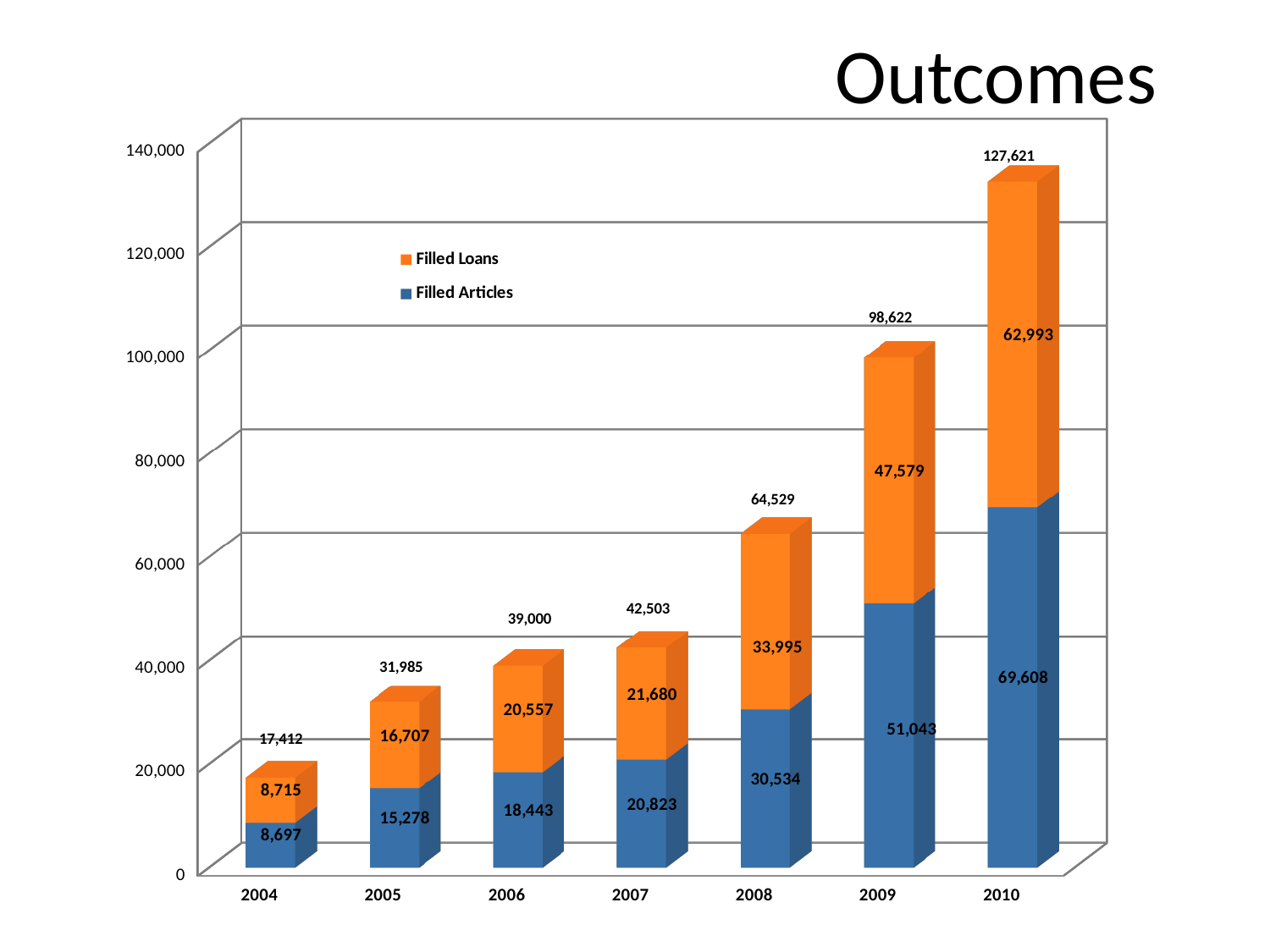
Which colour represents Filled Loans in the legend? Orange How many years are shown on the x axis? 7 Which is larger in 2007, Filled Loans or Filled Articles? Filled Loans What is the total of the stacked bar for 2009? 98,622 What is the value for Filled Articles in 2008? 30,534 Which year has the lowest value for Filled Articles? 2004 Which year has the highest total? 2010 What is the difference between Filled Loans and Filled Articles in 2010? 6,615 What kind of chart is shown? Stacked bar chart Do the total values rise or fall from 2004 to 2010? Rise What is the value for Filled Loans in 2006? 20,557 How many series does the legend list? 2